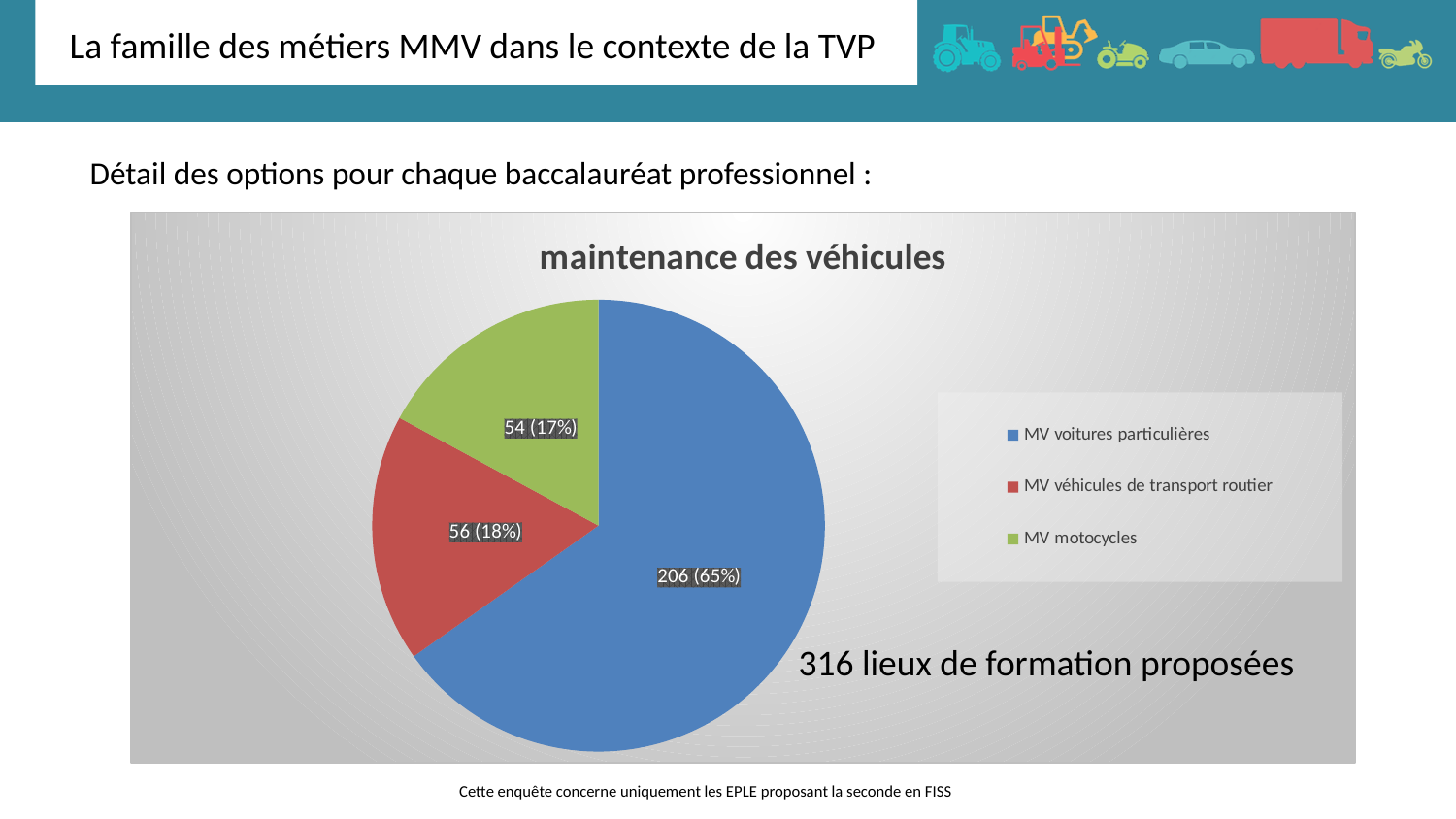
What is the total of the three slice values? 316 Which colour represents MV véhicules de transport routier in the pie chart? red What is the difference between the values for MV voitures particulières and MV véhicules de transport routier? 150 What kind of chart is shown on the slide? pie chart What is the value shown for MV voitures particulières? 206 (65%) What is the value shown for MV véhicules de transport routier? 56 (18%) What is the value shown for MV motocycles? 54 (17%) What share of the pie does MV motocycles represent? 17% What is the title of the chart? maintenance des véhicules Which category has the largest slice of the pie? MV voitures particulières How many slices does the pie chart have? 3 How many entries does the legend list? 3